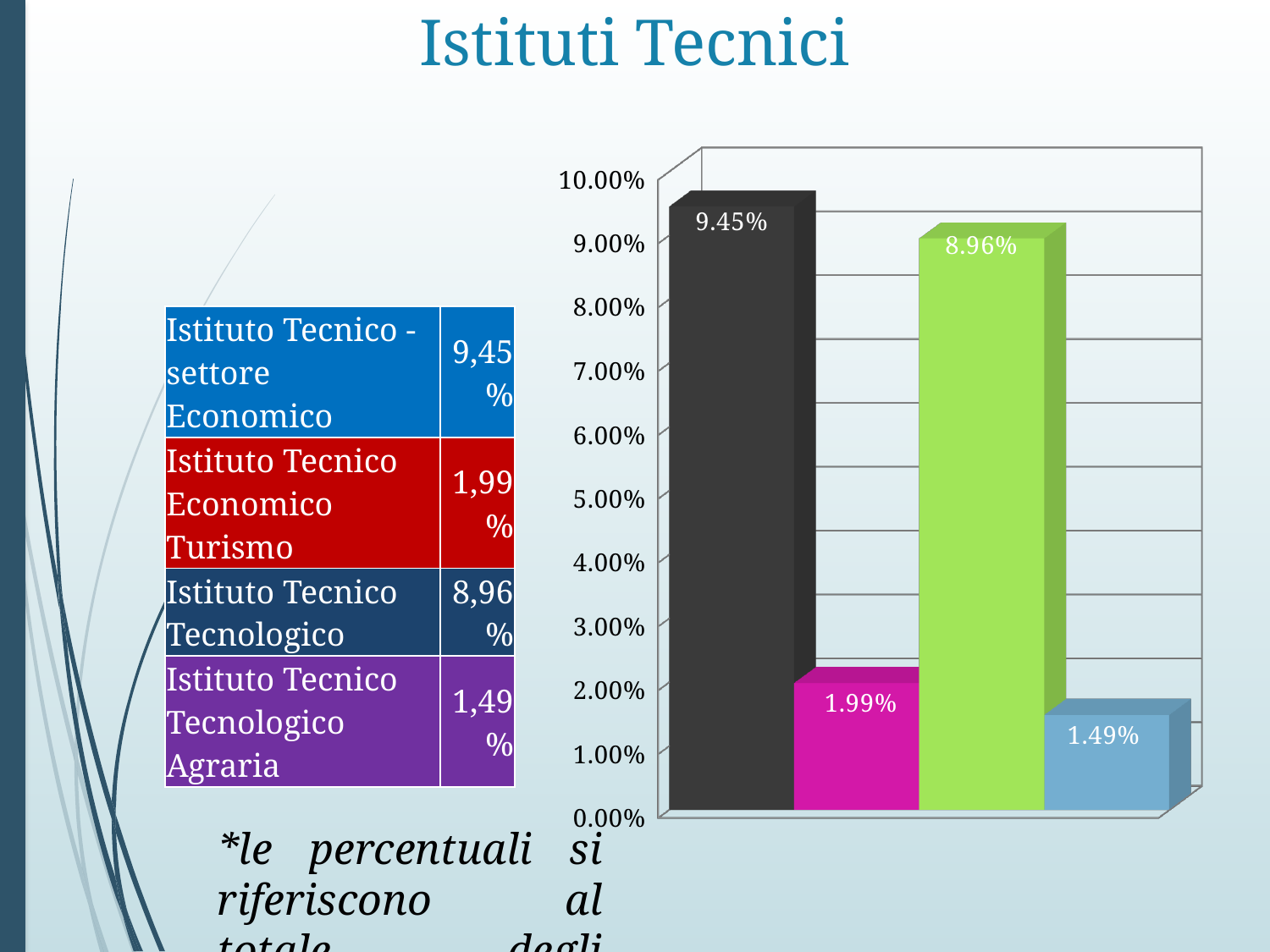
Which is larger, the value of the magenta bar or the value of the light blue bar? the magenta bar (1.99%) What is the title of the slide containing the chart? Istituti Tecnici What type of chart is shown on the slide? bar chart How many bars are plotted in the chart? 4 What is the value shown on the second (magenta) bar of the chart? 1.99% Which bar has the highest value in the chart? the first (black) bar, 9.45% What is the difference between the values of the black bar (9.45%) and the green bar (8.96%)? 0.49% What is the value shown on the fourth (light blue) bar of the chart? 1.49% What is the value shown on the first (black) bar of the chart? 9.45% What is the value shown on the third (green) bar of the chart? 8.96% What is the highest value shown on the chart's vertical axis? 10.00% Which bar has the lowest value in the chart? the fourth (light blue) bar, 1.49%